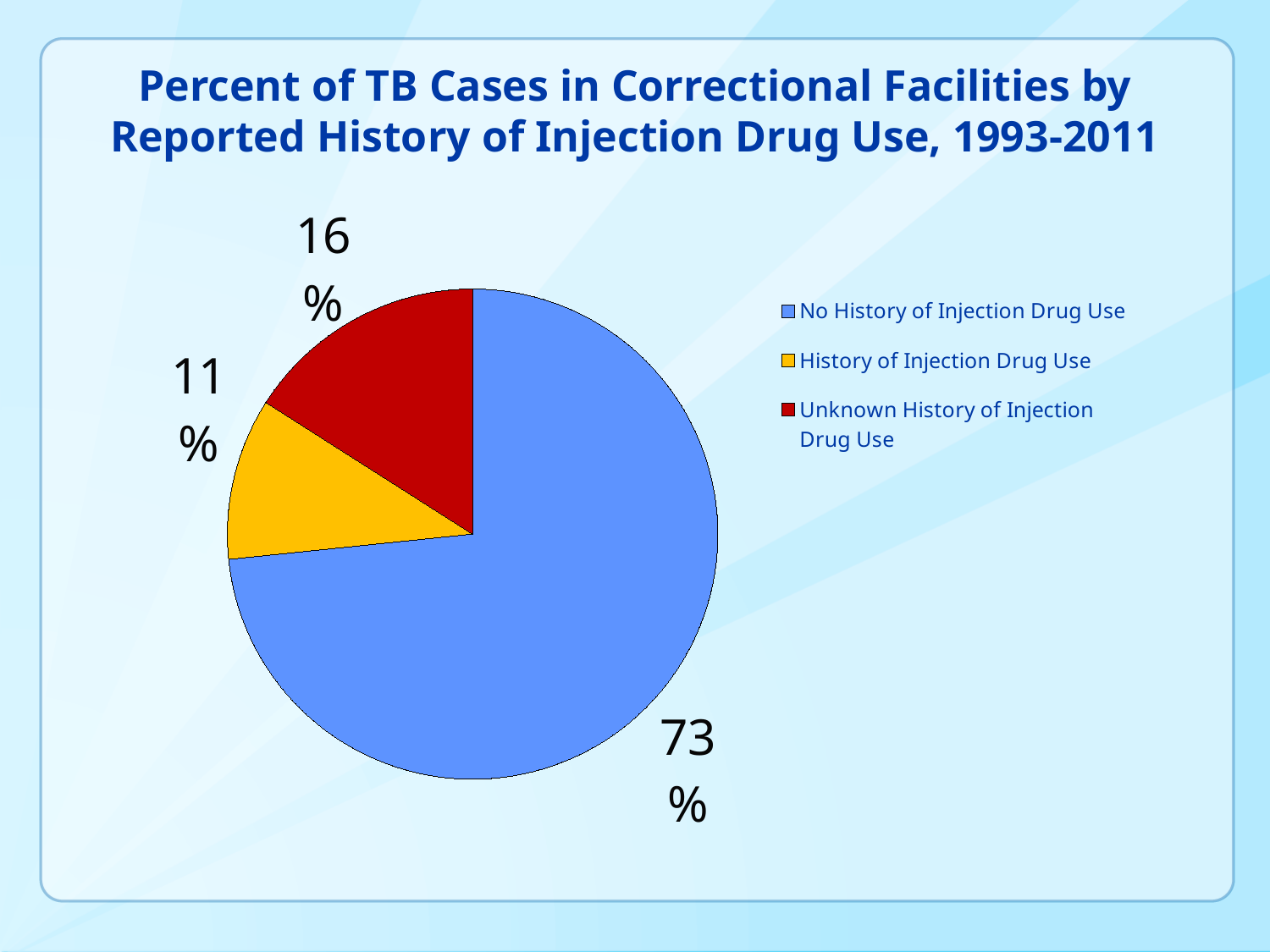
What colour is the slice for History of Injection Drug Use? yellow What time period does the chart title cover? 1993-2011 What is the difference in percentage points between the No History of Injection Drug Use slice and the Unknown History of Injection Drug Use slice? 57 What percentage of TB cases in correctional facilities had a history of injection drug use? 11% Which category accounts for the largest share of the pie? No History of Injection Drug Use How many categories does the pie chart show? 3 What percentage of TB cases in correctional facilities had no history of injection drug use? 73% Which category accounts for the smallest share of the pie? History of Injection Drug Use Which is larger: the share for Unknown History of Injection Drug Use or the share for History of Injection Drug Use? Unknown History of Injection Drug Use What kind of chart is shown on the slide? pie chart What is the combined percentage of cases with a known history of injection drug use and an unknown history of injection drug use? 27% What percentage of TB cases in correctional facilities had an unknown history of injection drug use? 16%